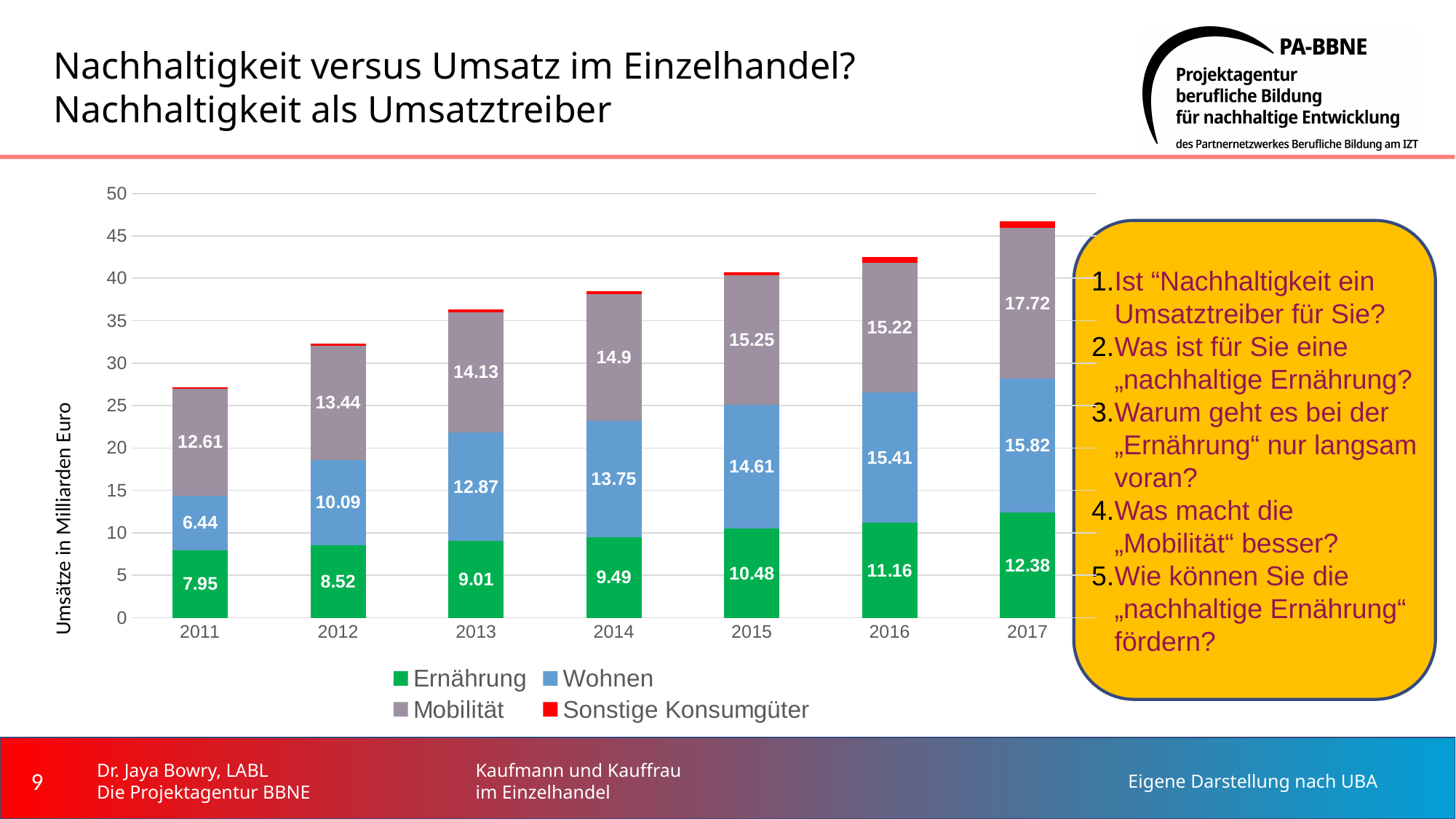
What is the value for Wohnen in 2013? 12.87 Is the total height of the 2017 stacked bar greater or less than 45? greater How many series does the legend list? 4 What is the value for Mobilität in 2015? 15.25 In which year is the Ernährung value lowest? 2011 What is the difference between the Wohnen values in 2017 and 2011? 9.38 What kind of chart is shown on the slide? stacked bar chart What is the value for Ernährung in 2017? 12.38 How many years are shown on the x axis? 7 Which is larger in 2012: the Wohnen value or the Mobilität value? Mobilität Does the Ernährung value rise or fall from 2011 to 2017? rise In which year is the Mobilität value highest? 2017